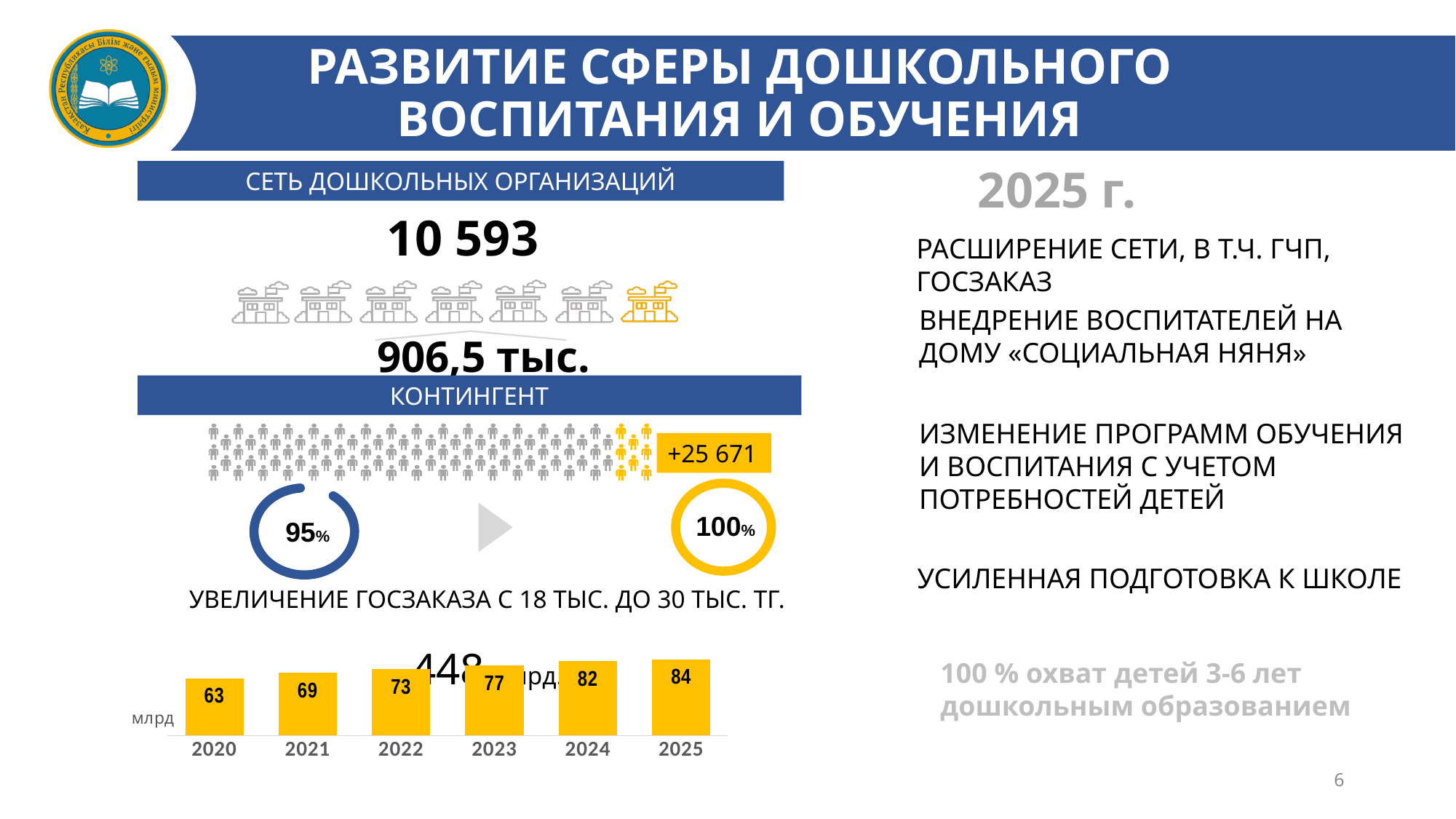
What type of chart is shown at the bottom of the slide? bar chart In the bar chart at the bottom of the slide, what is the value for 2023? 77 In the bar chart at the bottom of the slide, what is the value for 2020? 63 In the bar chart at the bottom of the slide, which year has the highest value? 2025 In the bar chart at the bottom of the slide, which is larger, the value for 2021 or the value for 2022? 2022 In the bar chart at the bottom of the slide, what is the difference between the values for 2025 and 2020? 21 In the bar chart at the bottom of the slide, what is the value for 2025? 84 What unit label is shown next to the bar chart at the bottom of the slide? млрд In the bar chart at the bottom of the slide, do the values rise or fall from 2020 to 2025? rise In the bar chart at the bottom of the slide, which year has the lowest value? 2020 How many years are shown in the bar chart at the bottom of the slide? 6 In the bar chart at the bottom of the slide, what is the difference between the values for 2024 and 2022? 9